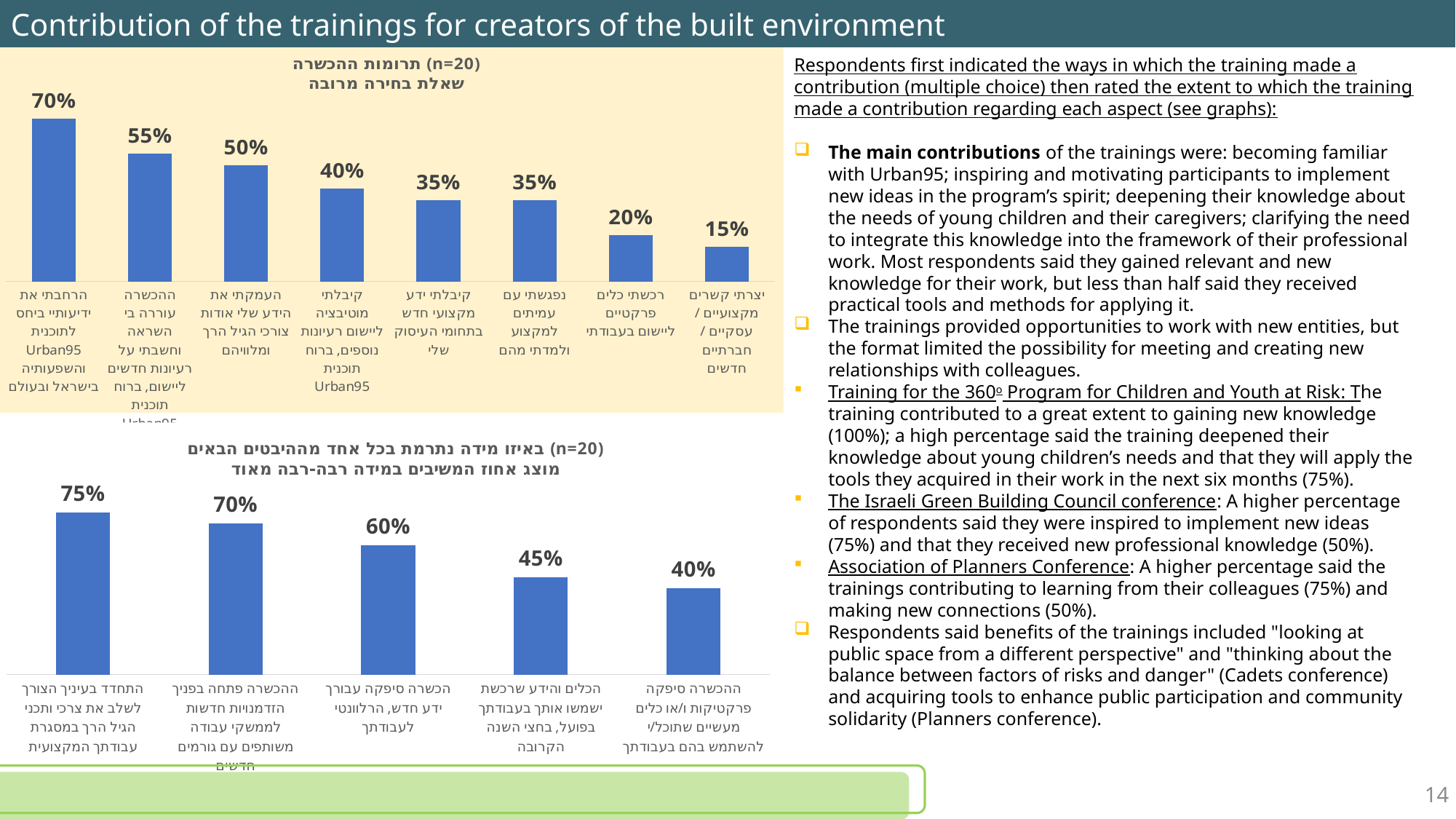
In the bottom chart (באיזו מידה נתרמת), what is the value for הכשרה סיפקה עבורך ידע חדש, הרלוונטי לעבודתך? 60% In the top chart (תרומות ההכשרה), how many bars are plotted? 8 In the top chart (תרומות ההכשרה), which category has the lowest value? יצרתי קשרים מקצועיים / עסקיים / חברתיים חדשים (15%) In the bottom chart (באיזו מידה נתרמת), how many categories are shown? 5 In the bottom chart (באיזו מידה נתרמת), what is the difference between the second bar (70%) and the rightmost bar (40%)? 30% In the bottom chart (באיזו מידה נתרמת), which is larger: the value for הכלים והידע שרכשת ישמשו אותך בעבודתך בפועל or the value for ההכשרה סיפקה פרקטיקות ו/או כלים מעשיים? הכלים והידע שרכשת ישמשו אותך בעבודתך בפועל (45%) In the top chart (תרומות ההכשרה), what is the value for רכשתי כלים פרקטיים ליישום בעבודתי? 20% In the top chart (תרומות ההכשרה), do the values rise or fall from left to right? fall In the bottom chart (באיזו מידה נתרמת), which category has the highest value? התחדד בעיניך הצורך לשלב את צרכי ותכני הגיל הרך במסגרת עבודתך המקצועית (75%) In the top chart (תרומות ההכשרה), what is the difference between the highest bar (70%) and the lowest bar (15%)? 55% What type of chart is the bottom chart on the slide? bar chart In the top chart (תרומות ההכשרה), what is the value of the leftmost bar (הרחבתי את ידיעותיי ביחס לתוכנית Urban95)? 70%